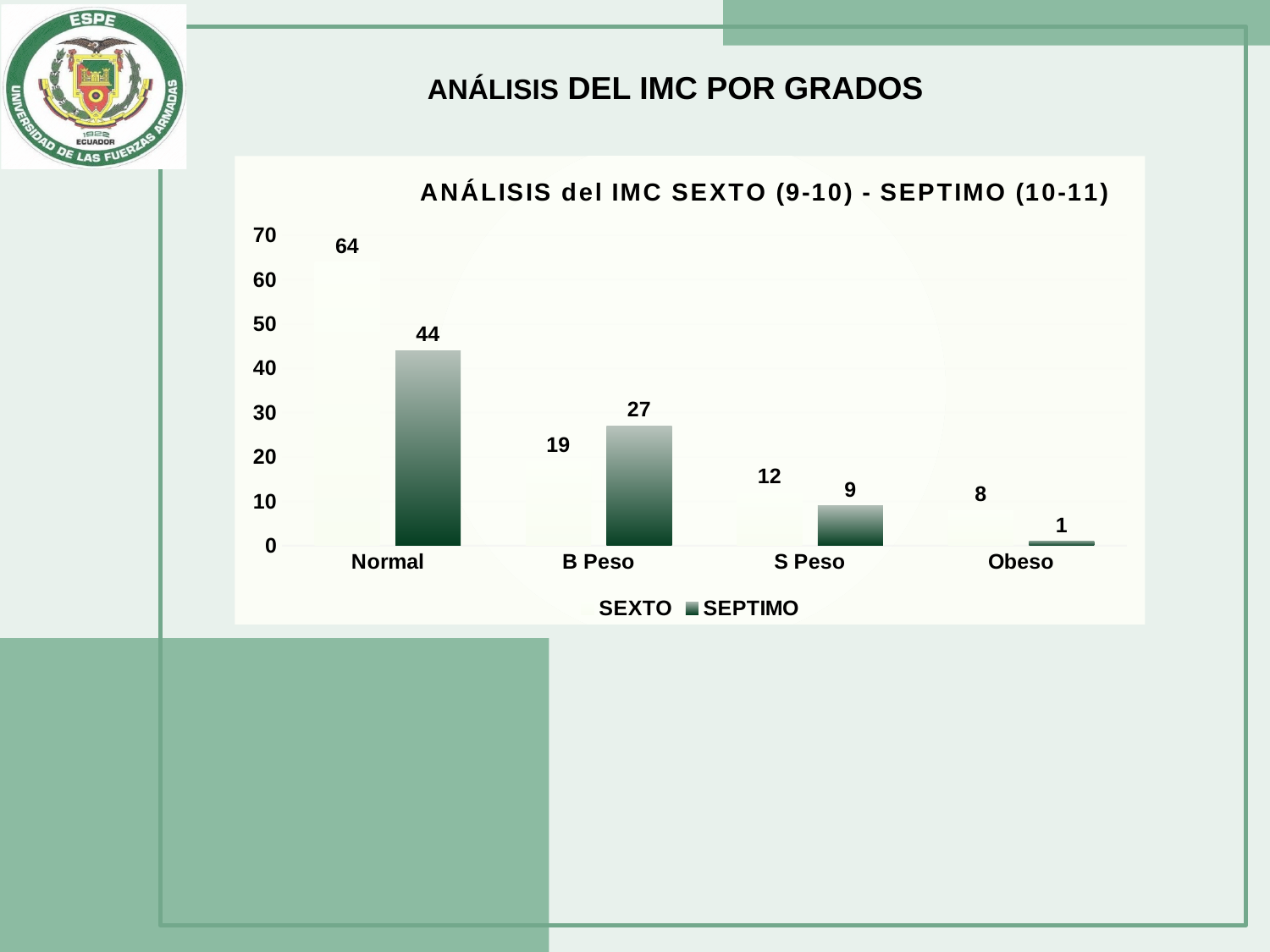
Which category has the lowest SEXTO value? Obeso Which category has the highest SEPTIMO value? Normal What kind of chart is shown on the slide? bar chart What is the value for SEPTIMO in the B Peso category? 27 How many categories are shown on the x axis? 4 What is the value for SEXTO in the Normal category? 64 What is the value for SEPTIMO in the Obeso category? 1 Which is larger for B Peso, the SEXTO value or the SEPTIMO value? SEPTIMO What is the value for SEXTO in the S Peso category? 12 How many series does the legend list? 2 What is the difference between the SEXTO and SEPTIMO values for Normal? 20 What is the title of the chart? ANÁLISIS del IMC SEXTO (9-10) - SEPTIMO (10-11)